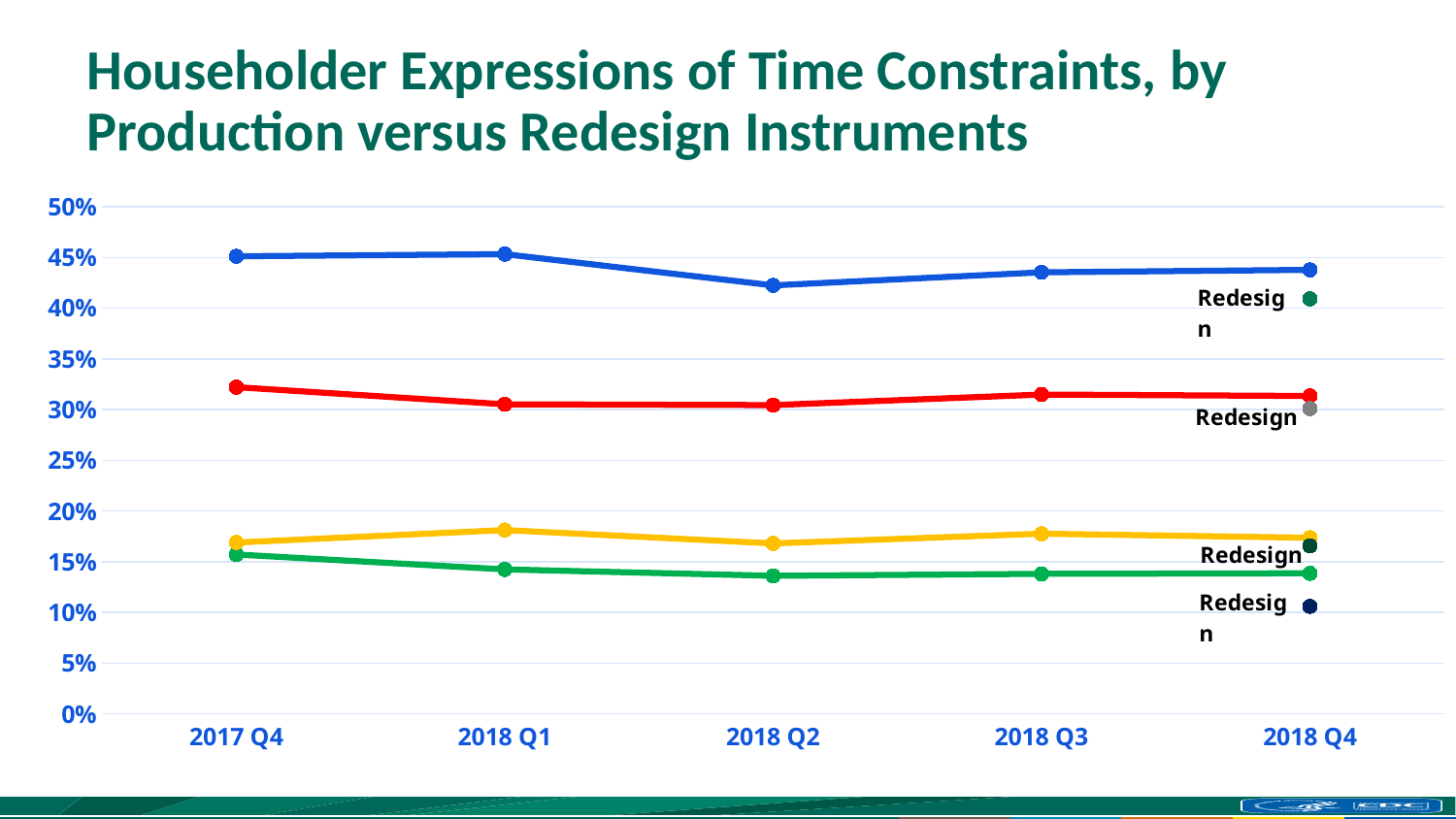
At 2018 Q2, which is larger: the yellow line or the green line? the yellow line Is the value of the green line at 2018 Q2 greater or less than 15%? less Is the value of the blue line at 2017 Q4 greater or less than 40%? greater In which quarter does the green line reach its highest point? 2017 Q4 Does the green line rise or fall from 2017 Q4 to 2018 Q2? fall How many quarters are shown along the x axis? 5 What kind of chart is shown on the slide? line chart What is the title of the chart? Householder Expressions of Time Constraints, by Production versus Redesign Instruments Is the value of the red line at 2018 Q1 greater or less than 35%? less Which line is the lowest across all quarters? the green line Which line is the highest across all quarters? the blue line In which quarter does the blue line reach its lowest point? 2018 Q2